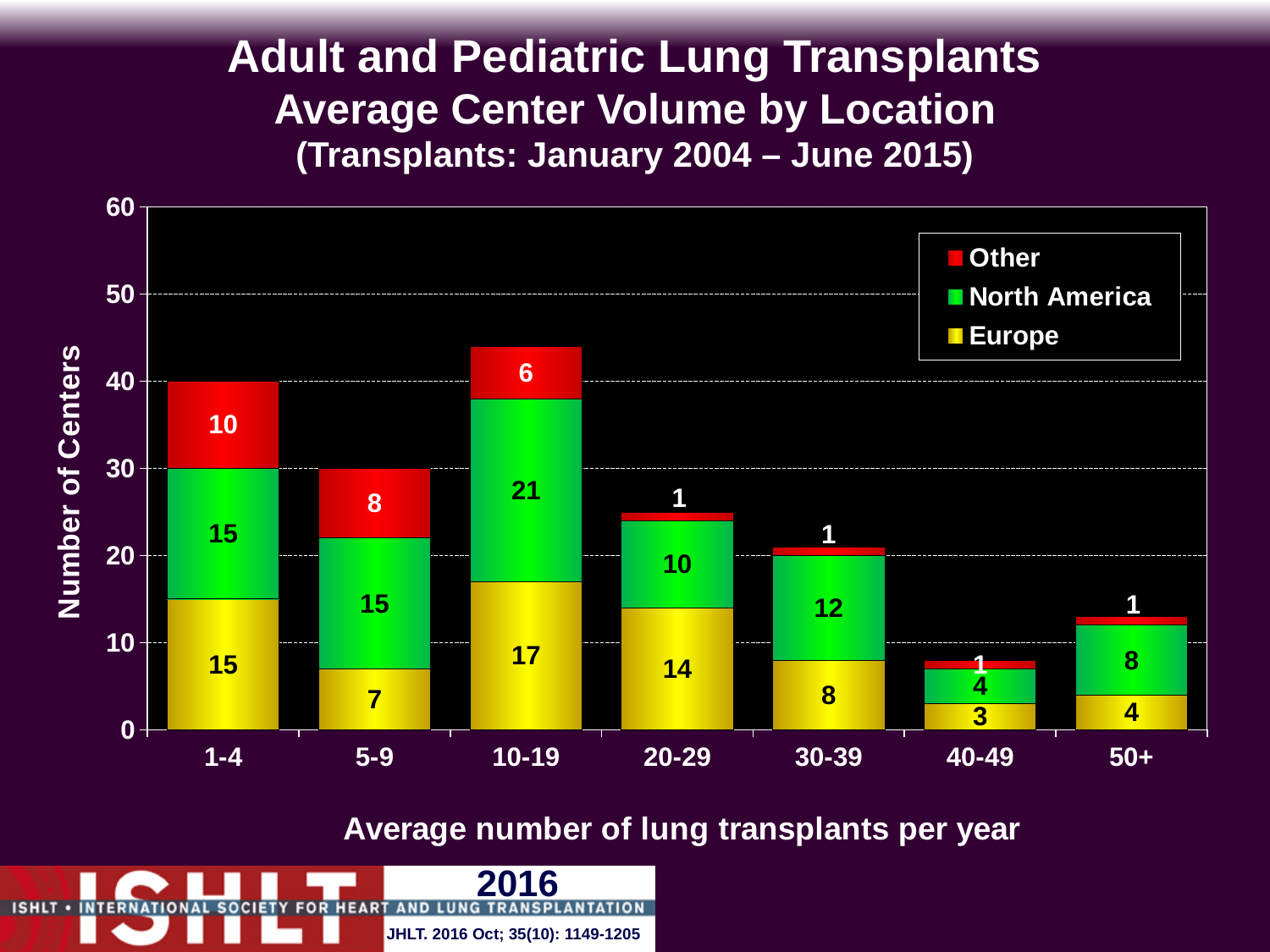
What is the total number of centers in the 40-49 category? 8 How many series does the legend list? 3 Which category has the lowest number of Europe centers? 40-49 Which category has the highest number of North America centers? 10-19 What is the difference between the Europe values for the 1-4 and 5-9 categories? 8 What is the number of North America centers in the 30-39 category? 12 What is the number of Europe centers in the 10-19 category? 17 What is the total number of centers in the 1-4 category? 40 Which is larger, the Europe value for 20-29 or the North America value for 20-29? Europe (14) What type of chart is shown on the slide? Stacked bar chart What is the number of Other centers in the 5-9 category? 8 How many categories are shown on the x axis? 7